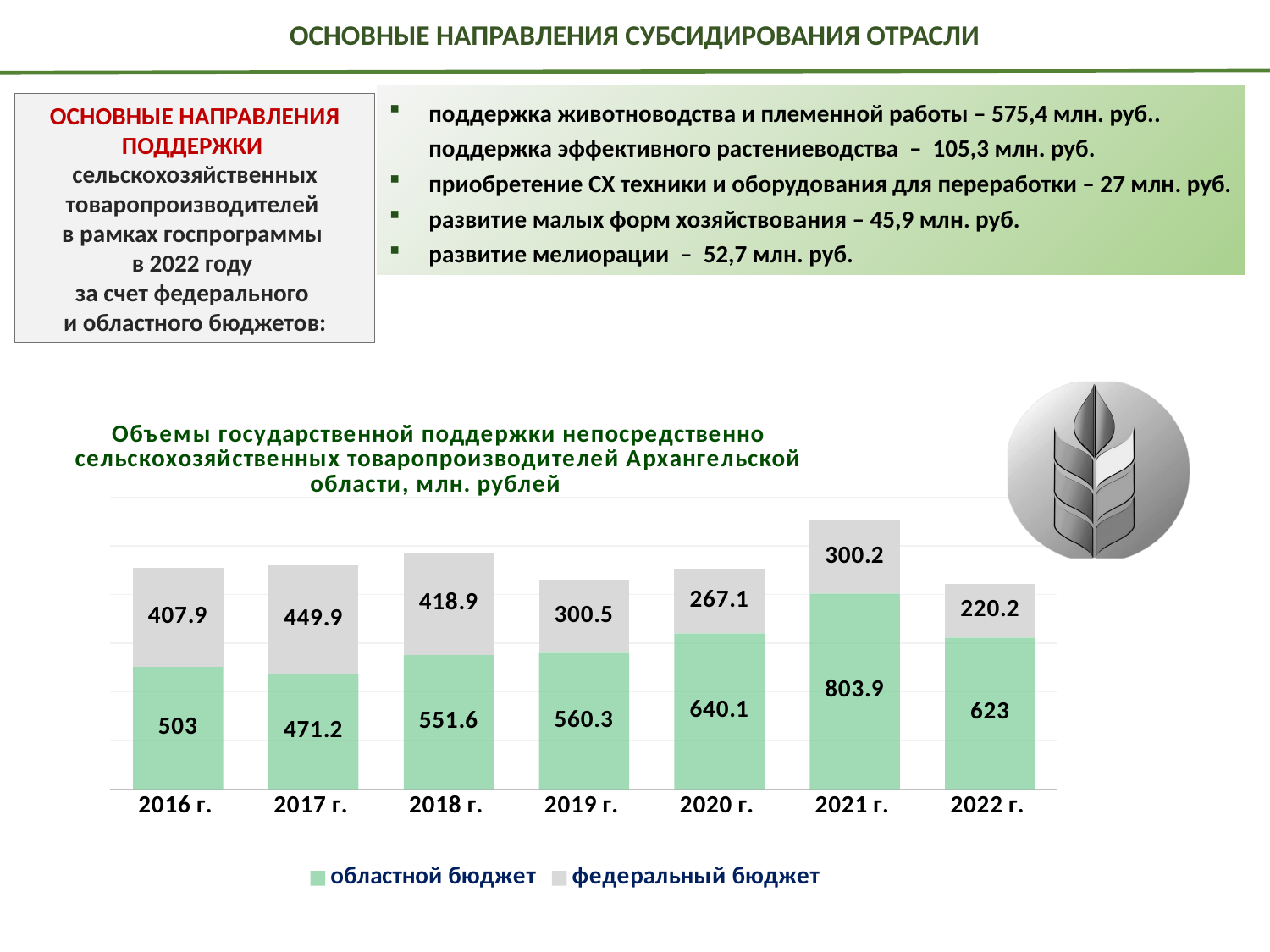
Which year has the lowest value for федеральный бюджет? 2022 г. What is the total of the stacked bar for 2016 г.? 910.9 Which year has the highest value for областной бюджет? 2021 г. What is the difference between the областной бюджет values for 2021 г. and 2020 г.? 163.8 Which is larger: федеральный бюджет in 2017 г. or in 2018 г.? 2017 г. Which series is shown in green in the chart? областной бюджет What is the value of областной бюджет for 2022 г.? 623 What is the value of федеральный бюджет for 2019 г.? 300.5 How many series does the chart legend list? 2 What type of chart is shown on the slide? stacked bar chart What is the value of областной бюджет for 2021 г.? 803.9 How many years are shown on the x axis of the chart? 7